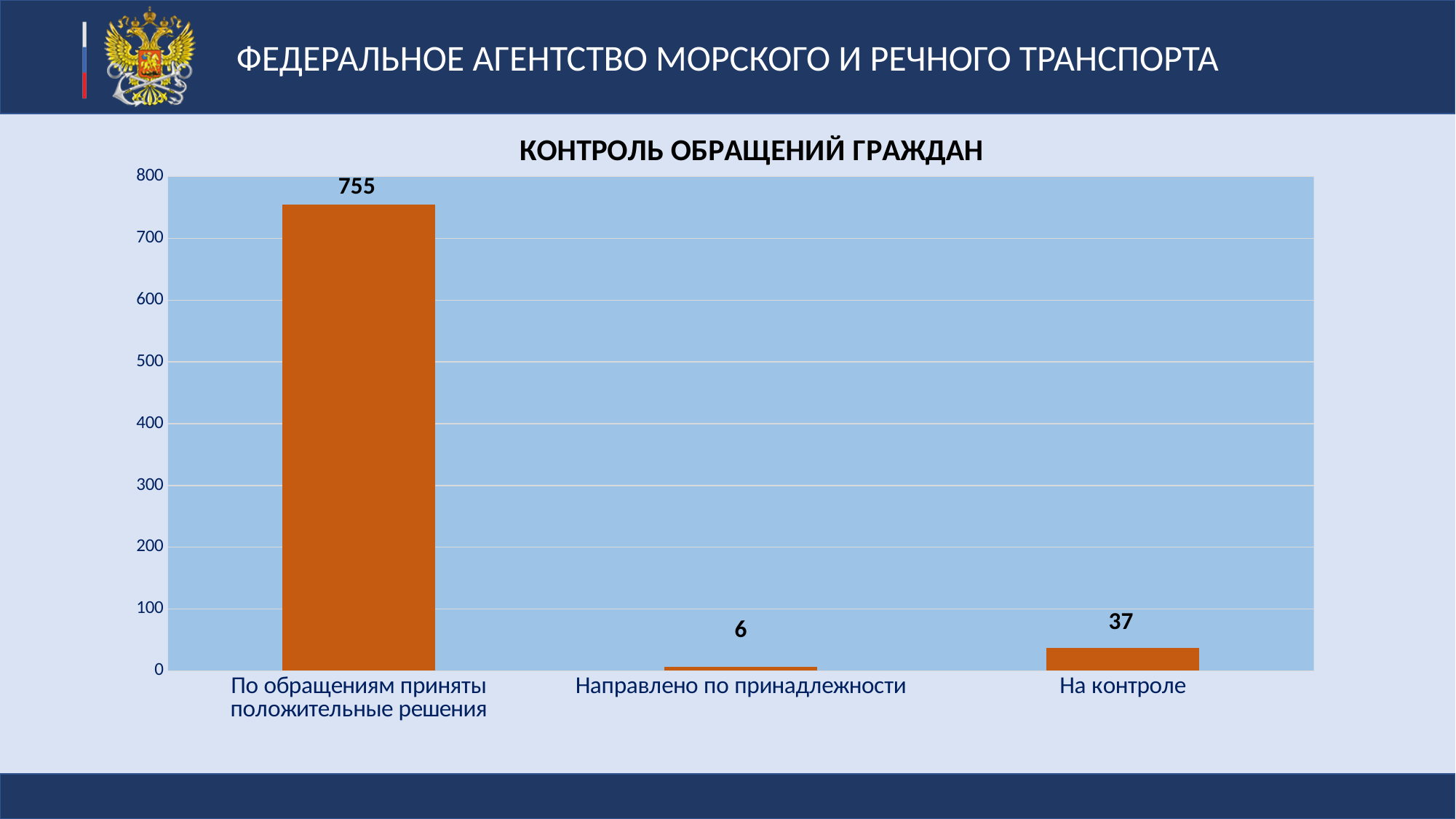
What is the title of the chart? КОНТРОЛЬ ОБРАЩЕНИЙ ГРАЖДАН How many categories are shown on the chart? 3 Is the value for "По обращениям приняты положительные решения" greater or less than 700? greater What is the value for "По обращениям приняты положительные решения"? 755 What is the difference between the values for "По обращениям приняты положительные решения" and "На контроле"? 718 Which is larger: the value for "На контроле" or the value for "Направлено по принадлежности"? На контроле What is the value for "На контроле"? 37 Which category has the highest value? По обращениям приняты положительные решения What kind of chart is shown on the slide? Bar chart What is the difference between the values for "На контроле" and "Направлено по принадлежности"? 31 What is the value for "Направлено по принадлежности"? 6 Which category has the lowest value? Направлено по принадлежности